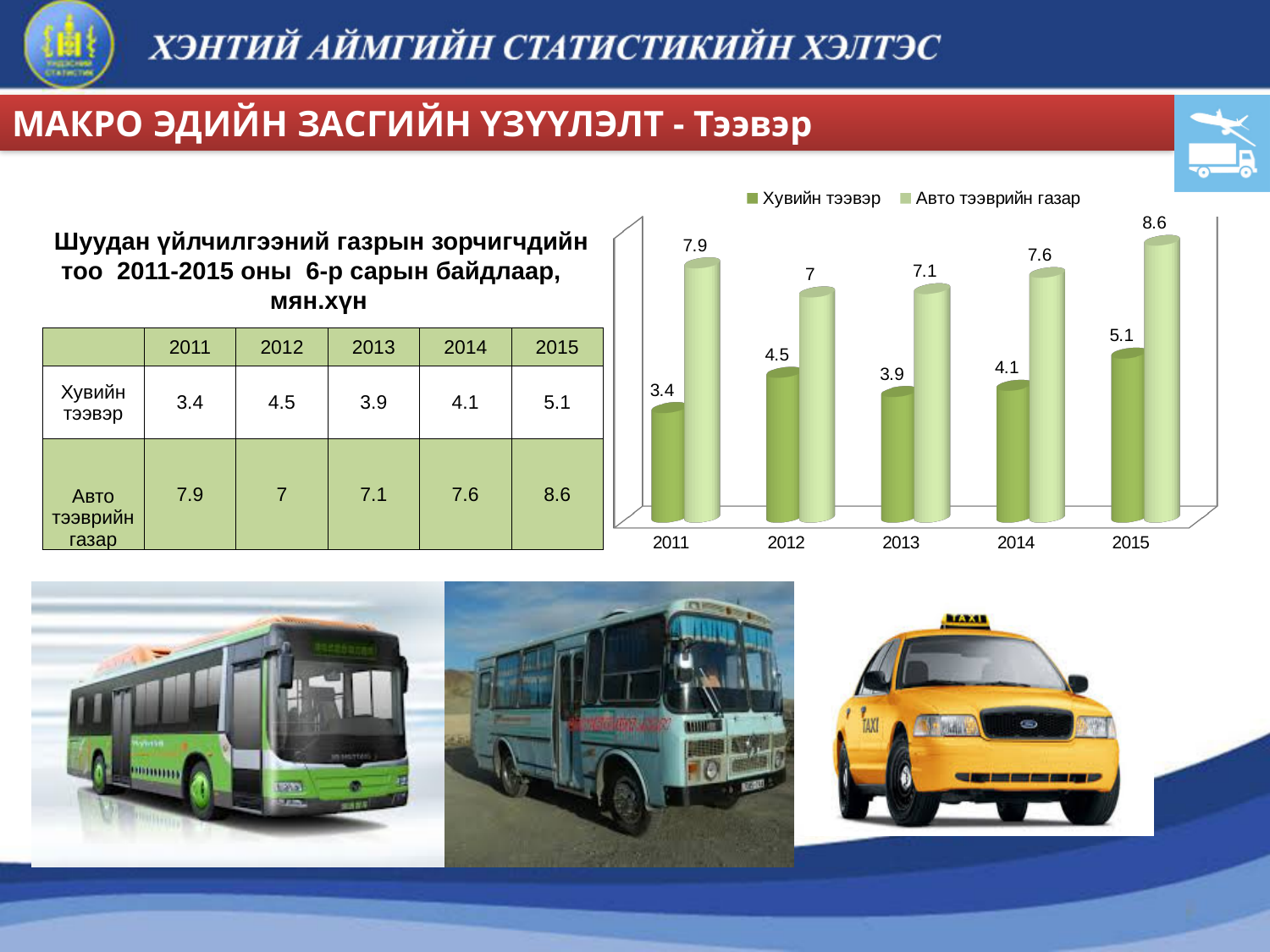
What is the difference between Авто тээврийн газар and Хувийн тээвэр in 2015? 3.5 What kind of chart is shown on the slide? bar chart In which year is the value for Хувийн тээвэр lowest? 2011 What is the difference between the Хувийн тээвэр values for 2012 and 2011? 1.1 In which year is the value for Авто тээврийн газар highest? 2015 What is the value for Хувийн тээвэр in 2013? 3.9 How many series does the chart legend list? 2 What is the value for Авто тээврийн газар in 2014? 7.6 How many years are shown on the x axis of the chart? 5 Does the value for Хувийн тээвэр rise or fall from 2014 to 2015? rise Which series is shown in the darker green bars in the chart? Хувийн тээвэр Which series has the larger value in 2012, Хувийн тээвэр or Авто тээврийн газар? Авто тээврийн газар